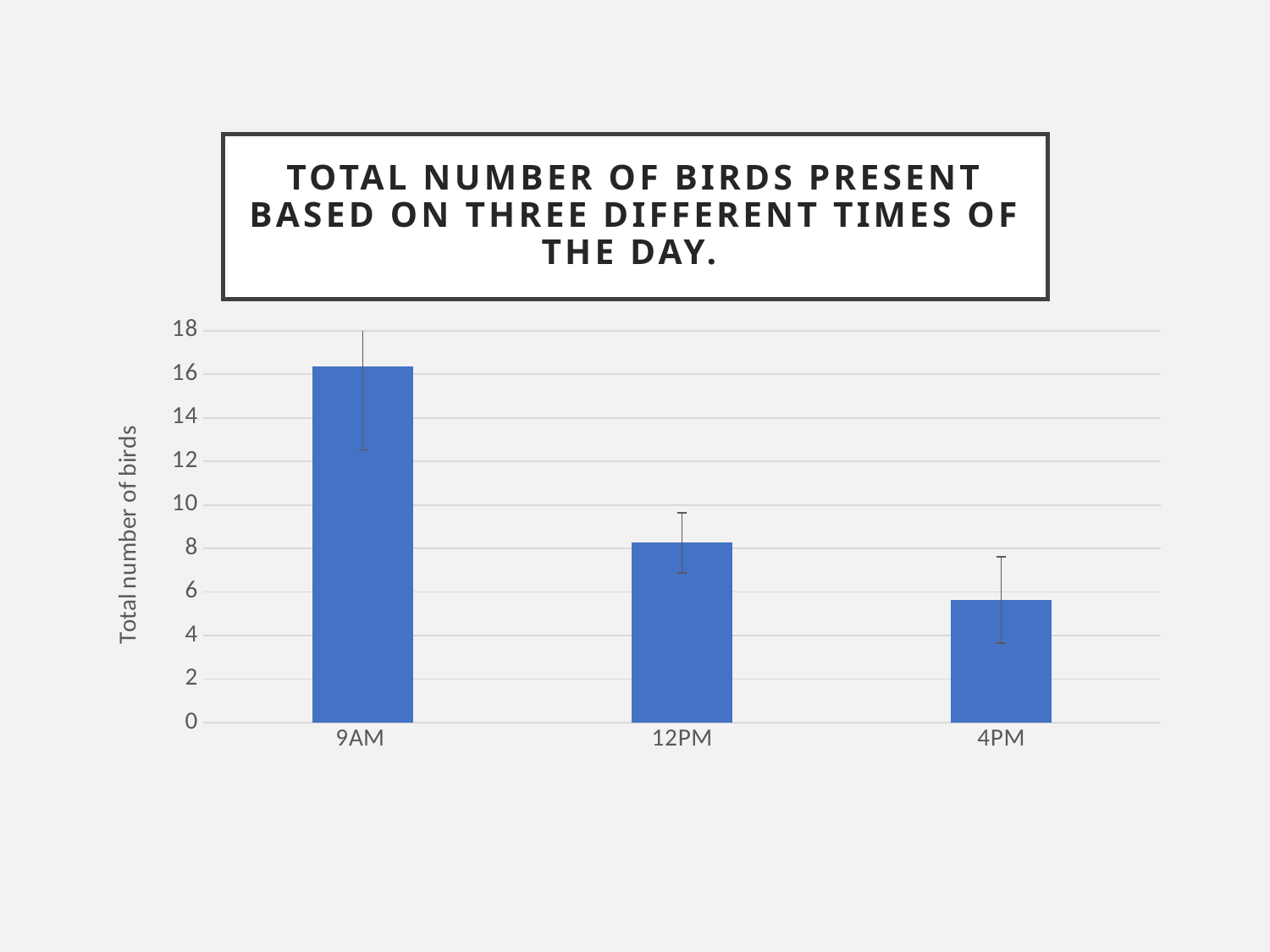
What is the label of the vertical axis? Total number of birds How many time-of-day categories are plotted on the chart? 3 Which time of day has the lowest total number of birds? 4PM Is the value for 4PM greater or less than 6? less What kind of chart is shown on the slide? bar chart Which time of day has the highest total number of birds? 9AM What is the title of the chart? TOTAL NUMBER OF BIRDS PRESENT BASED ON THREE DIFFERENT TIMES OF THE DAY. Is the value for 9AM greater or less than 18? less Do the values rise or fall from 9AM to 4PM along the x axis? fall Is the value for 9AM greater or less than 16? greater Which has a larger value, 12PM or 4PM? 12PM